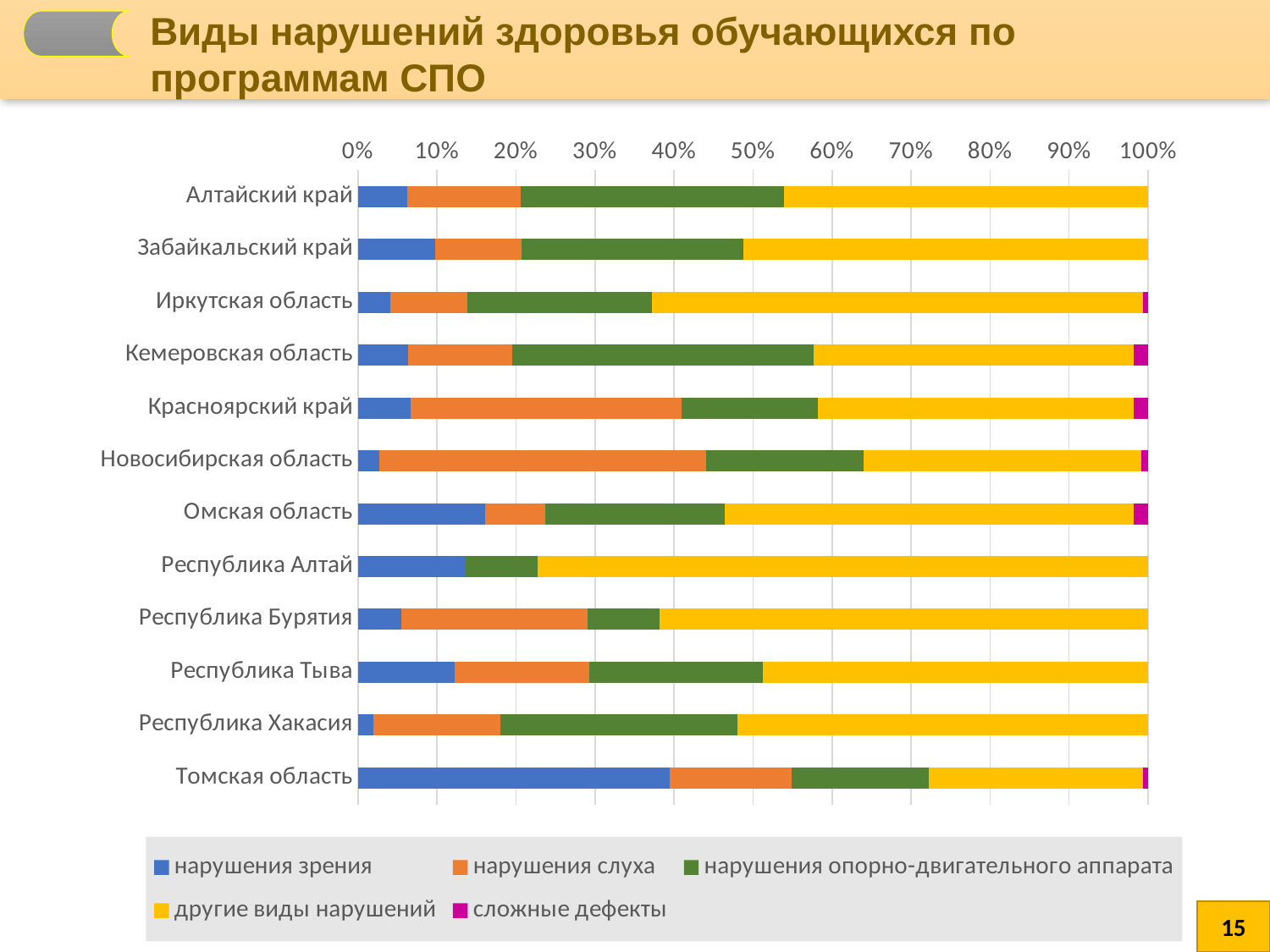
How many regions (categories) are plotted on the chart? 12 Which region has the largest share of 'нарушения слуха' (orange segment)? Новосибирская область What colour represents 'сложные дефекты' in the legend? Magenta (pink) Which region has the largest share of 'нарушения зрения' (blue segment)? Томская область How many series does the legend list? 5 What kind of chart is shown on the slide? Stacked bar chart Is the share of 'другие виды нарушений' for Республика Алтай greater or less than 70%? greater Which region has the smallest share of 'другие виды нарушений' (yellow segment)? Томская область Is the share of 'нарушения зрения' for Республика Хакасия greater or less than 10%? less Which region has the larger share of 'нарушения зрения': Омская область or Республика Бурятия? Омская область Is the share of 'нарушения зрения' for Томская область greater or less than 30%? greater Which region has the largest share of 'другие виды нарушений' (yellow segment)? Республика Алтай